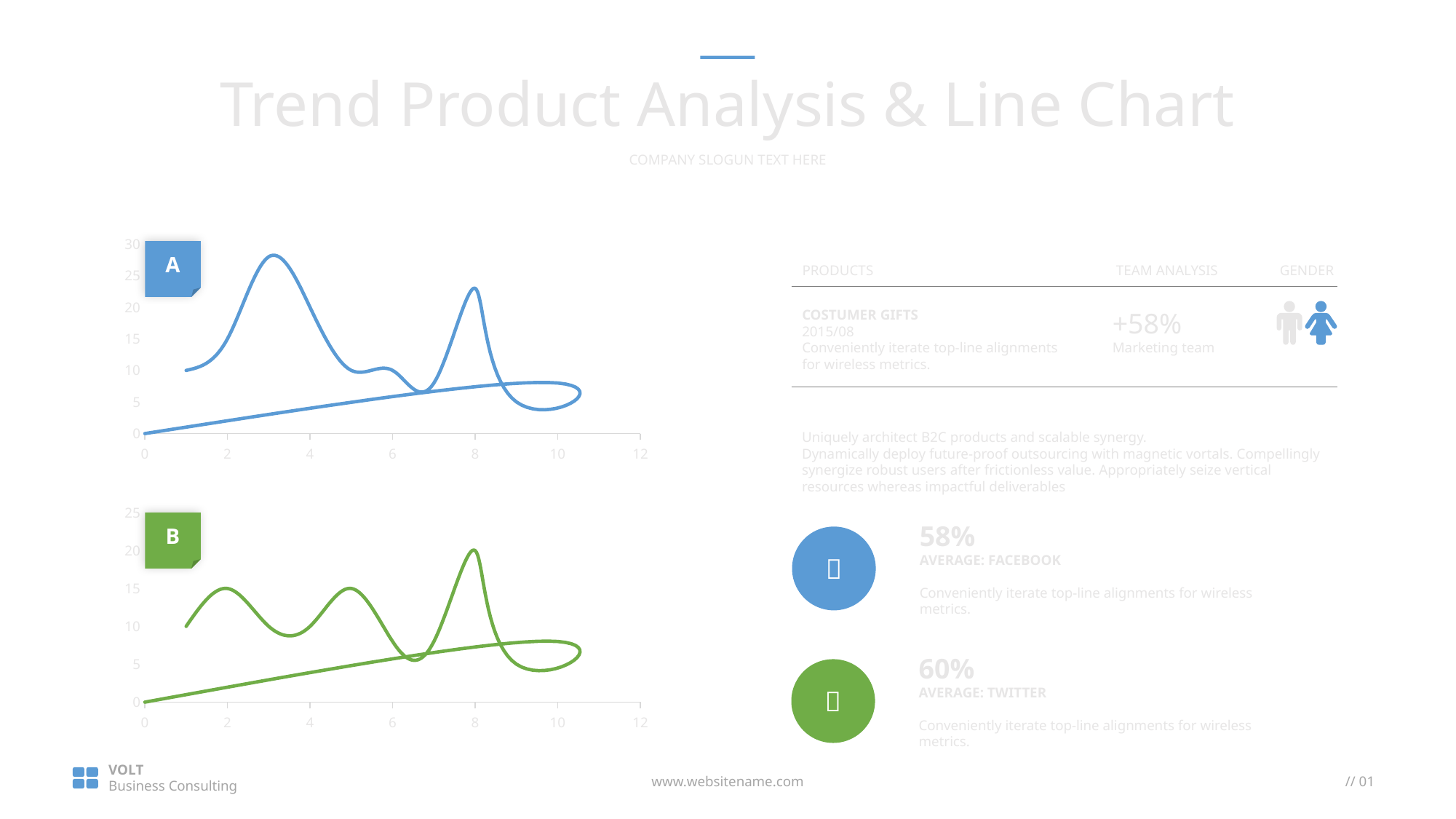
How many lines are plotted in chart A? 2 In chart B, is the peak of the wavy line near x = 8 greater or less than 15? greater In chart B, what is the highest value shown on the y axis? 25 In chart A, is the peak of the wavy line near x = 8 greater or less than 20? greater Which chart has the higher maximum peak, chart A or chart B? chart A What kind of chart is chart B (the bottom chart)? line chart In chart A, is the highest peak of the wavy line (near x = 3) greater or less than 25? greater In chart B, does the smooth line rise or fall from x = 0 to x = 8? rises In chart A, what is the highest value shown on the y axis? 30 What kind of chart is chart A (the top chart)? line chart